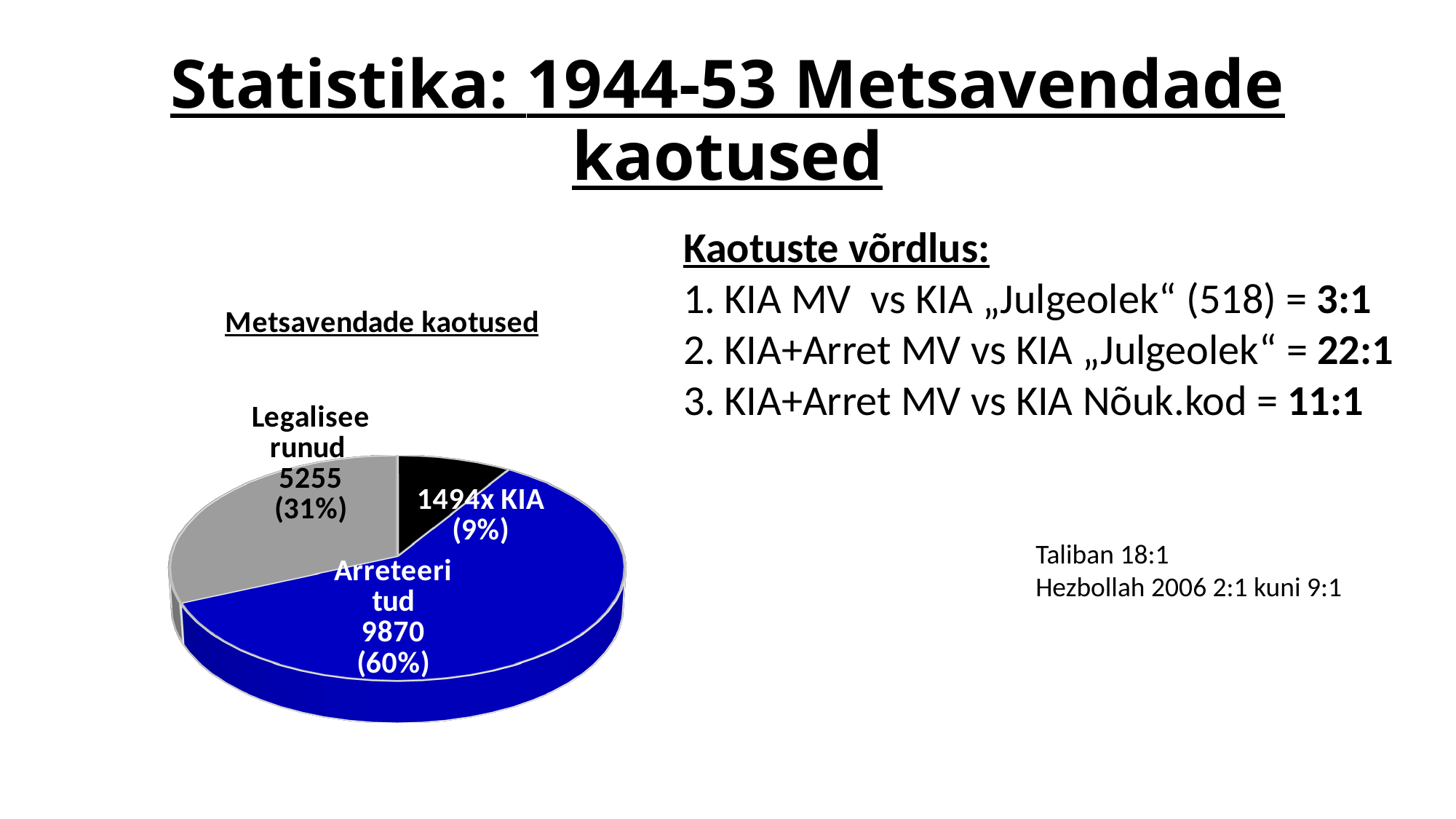
What is the title of the chart? Metsavendade kaotused What is the value shown for KIA? 1494 What is the value shown for Arreteeritud? 9870 What share of the pie does Legaliseerunud represent? 31% What share of the pie does KIA represent? 9% What kind of chart is shown on the slide? pie chart What is the value shown for Legaliseerunud? 5255 What share of the pie does Arreteeritud represent? 60% Which slice is the largest? Arreteeritud How many slices does the pie chart have? 3 What is the difference between the Arreteeritud and Legaliseerunud values? 4615 Which slice is the smallest? KIA